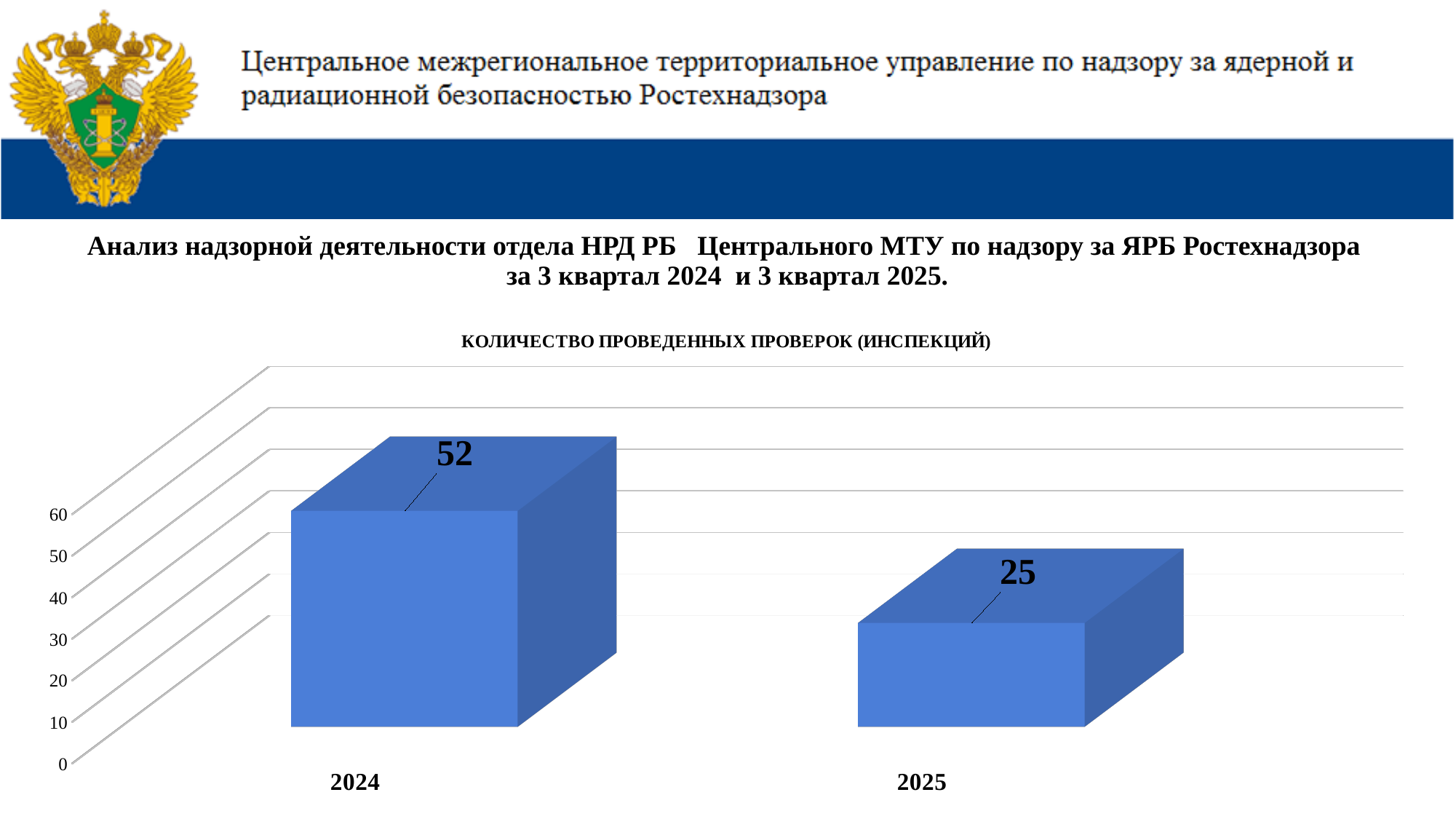
What is the difference between the values for 2024 and 2025? 27 What is the value for 2025? 25 What is the value for 2024? 52 Is the value for 2025 greater or less than 30? less Which year has the lowest number of inspections? 2025 Which is larger, the value for 2024 or the value for 2025? 2024 How many categories are shown on the x axis? 2 Is the value for 2024 greater or less than 50? greater What is the title of the chart? КОЛИЧЕСТВО ПРОВЕДЕННЫХ ПРОВЕРОК (ИНСПЕКЦИЙ) Which year has the highest number of inspections? 2024 What kind of chart is shown on the slide? bar chart Do the values rise or fall from 2024 to 2025? fall